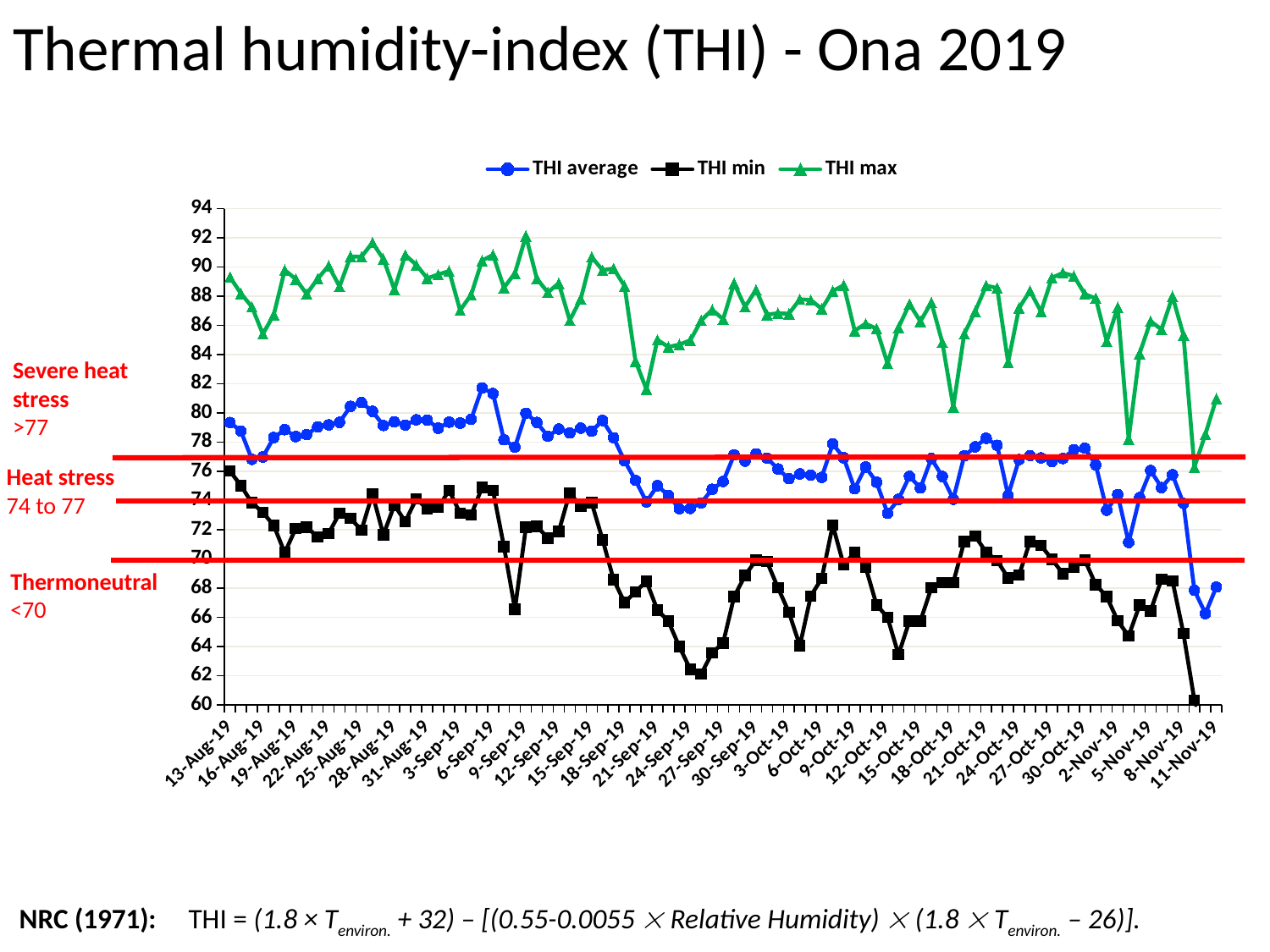
Is the value of THI max on 6-Sep-19 greater or less than 88? greater Is the value of THI average on 13-Aug-19 greater or less than 78? greater According to the red annotation, what THI range is labelled as heat stress? 74 to 77 Does THI min rise or fall overall from 13-Aug-19 to 27-Sep-19? fall Which series has the lowest values across the whole period? THI min Is the value of THI min on 24-Sep-19 greater or less than 70? less What kind of chart is shown on the slide? line chart Which series is plotted with green triangle markers? THI max On 13-Aug-19, which is larger: THI max or THI average? THI max Which series has the highest values across the whole period? THI max How many series does the legend list? 3